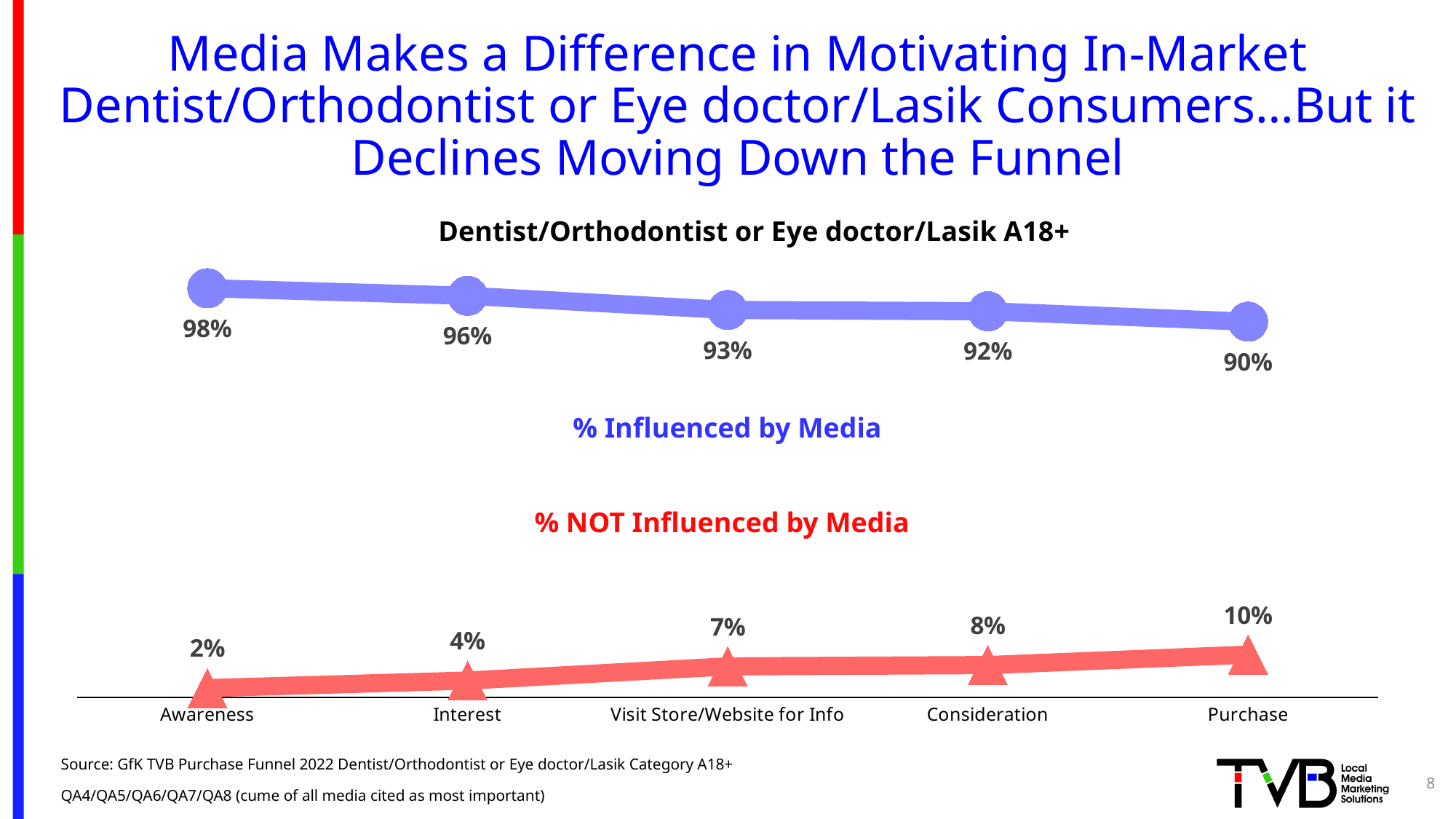
At which funnel stage is the % NOT Influenced by Media highest? Purchase What is the % NOT Influenced by Media value at the Purchase stage? 10% What is the difference between the % Influenced by Media at Awareness and at Purchase? 8 percentage points How many funnel stages are shown on the x axis? 5 How many data series are plotted on the chart? 2 What is the % Influenced by Media value for Consideration? 92% Which is larger: the % NOT Influenced by Media at Interest or at Consideration? Consideration What percentage of consumers are influenced by media at the Awareness stage? 98% Does the % Influenced by Media rise or fall moving from Awareness to Purchase? Fall What type of chart is shown? Line chart At which funnel stage is the % Influenced by Media lowest? Purchase What is the % NOT Influenced by Media value for Visit Store/Website for Info? 7%